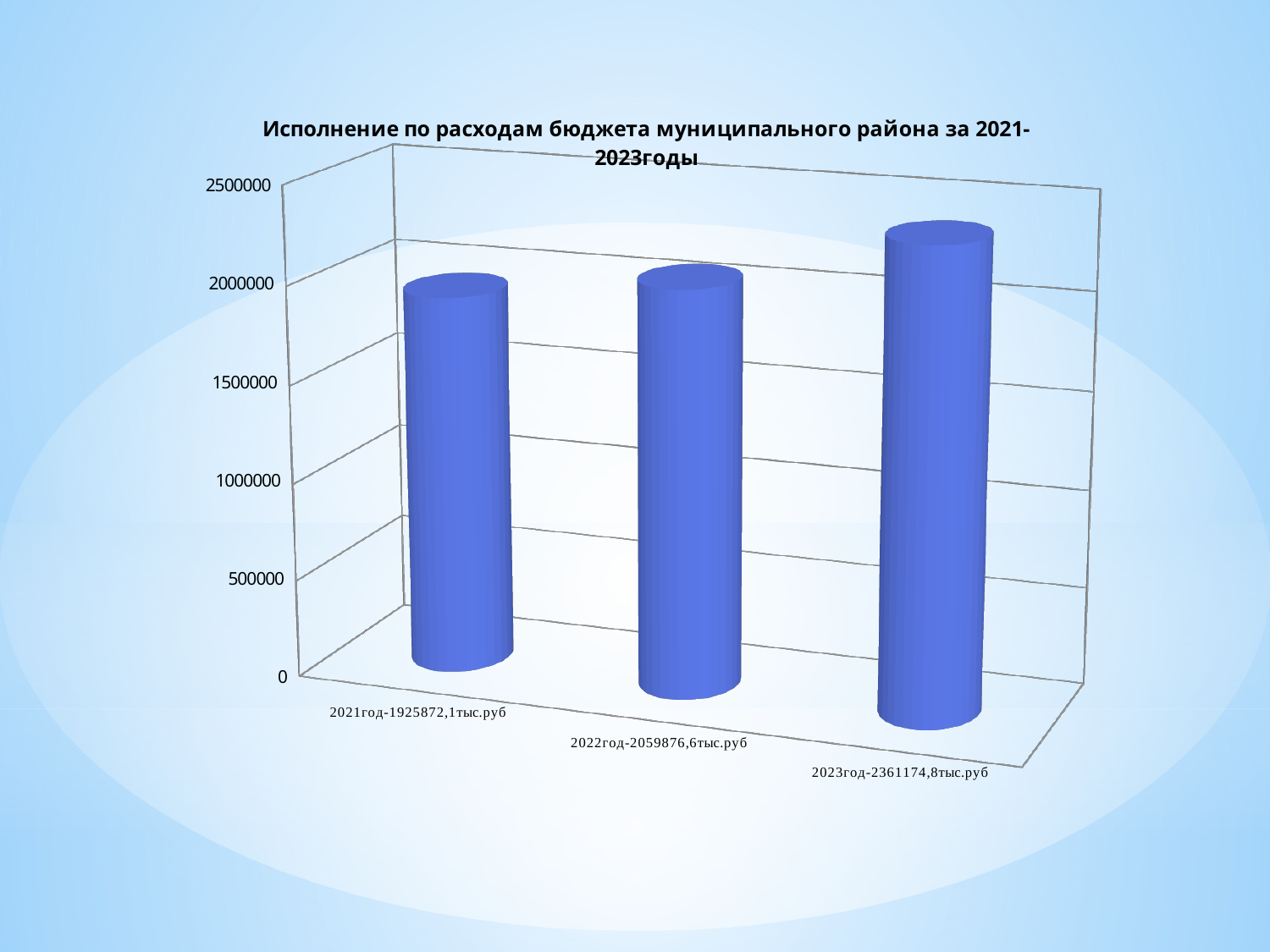
What is the difference between the 2023 and 2021 values? 435302,7тыс.руб How many bars are plotted in the chart? 3 Which year has the highest budget expenditure in the chart? 2023 What is the difference between the 2022 and 2021 values? 134004,5тыс.руб What value is shown for 2021 in the chart? 1925872,1тыс.руб Do the values rise or fall from 2021 to 2023? rise What kind of chart is shown on the slide? bar chart Which is larger, the value for 2022 or the value for 2023? 2023 Is the value for 2021 greater or less than 2000000? less Which year has the lowest budget expenditure in the chart? 2021 What value is shown for 2022 in the chart? 2059876,6тыс.руб What value is shown for 2023 in the chart? 2361174,8тыс.руб